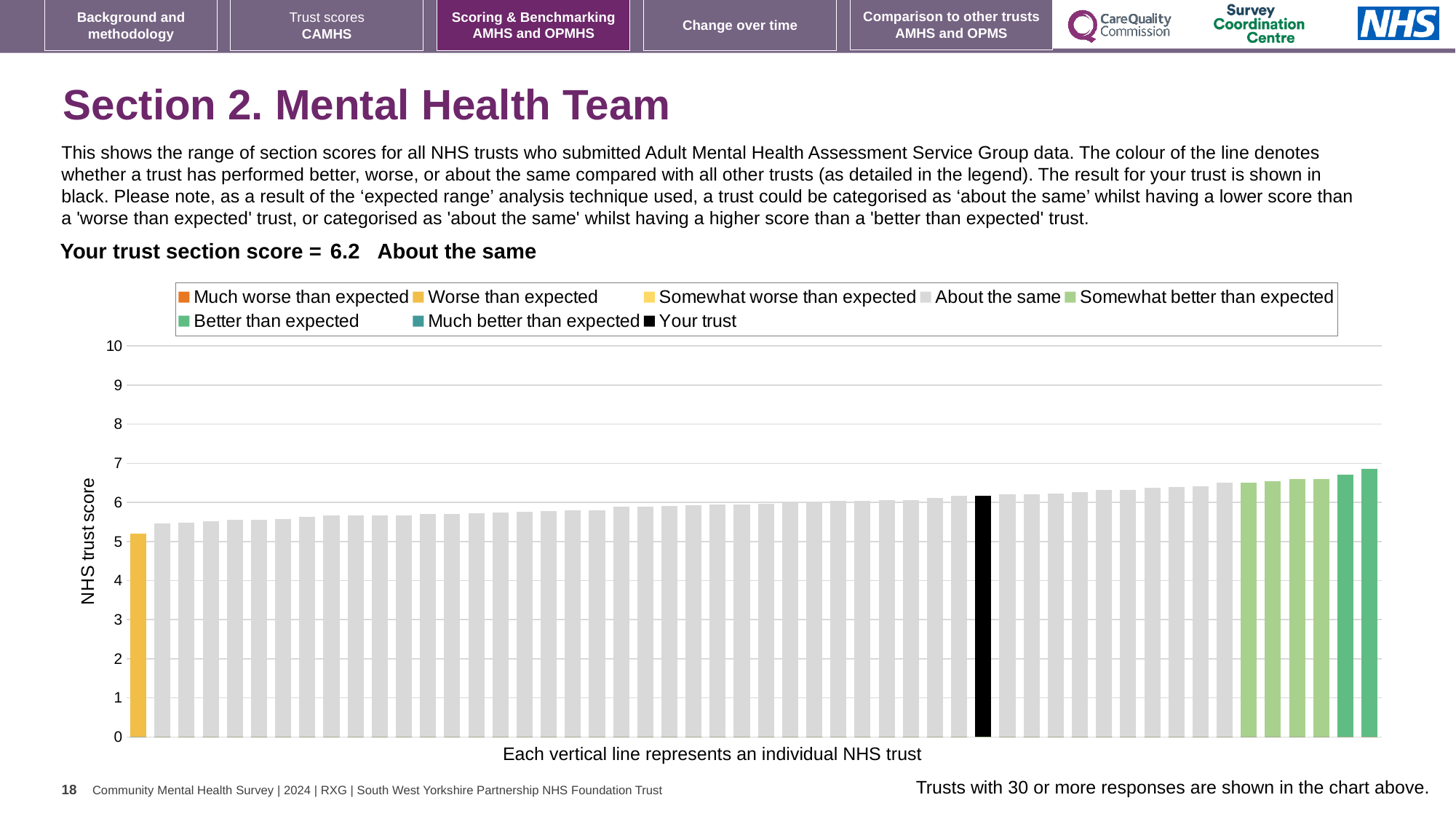
Which category is your trust placed in, as stated on the slide? About the same What is the label on the vertical axis of the chart? NHS trust score How many entries does the chart legend list? 8 How many bars on the chart are coloured yellow (Worse than expected)? 1 Do the bar values rise or fall from left to right along the x axis? rise Is the value of the rightmost (highest) bar greater or less than 7? less Which category does the lowest bar on the chart belong to, according to its colour and the legend? Worse than expected Is the value of the black 'Your trust' bar greater or less than 6? greater What is the highest value shown on the vertical axis? 10 Is the value of the leftmost (lowest) bar greater or less than 6? less What kind of chart is shown on the slide? bar chart What is the section score for your trust shown on the slide? 6.2